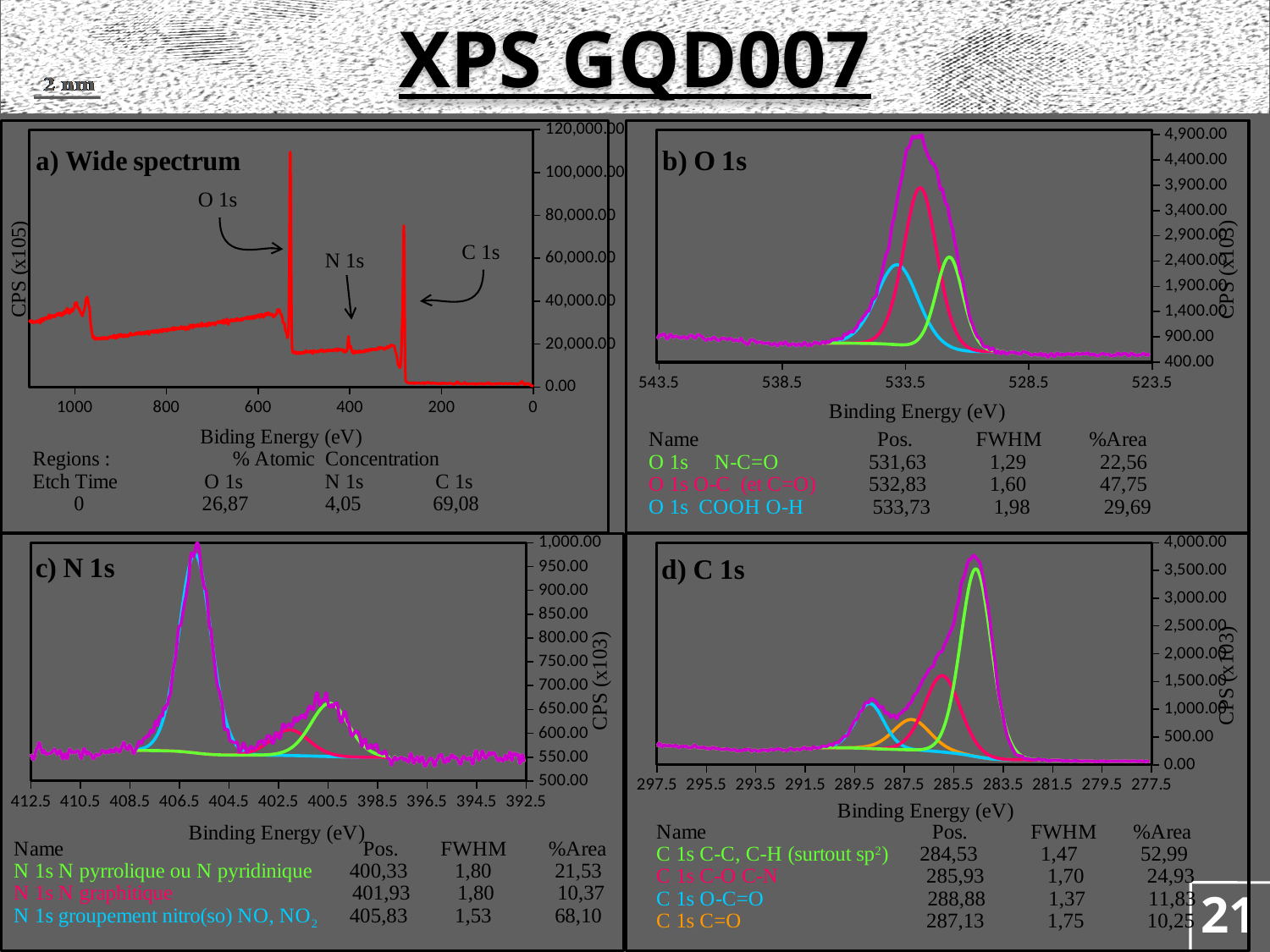
In the a) Wide spectrum panel, which region has the highest % Atomic Concentration? C 1s In the d) C 1s chart, what is the difference in %Area between C 1s C-C, C-H (surtout sp2) and C 1s C-O C-N? 28,06 In the b) O 1s chart, which component has the largest %Area? O 1s O-C (et C=O) In the b) O 1s chart, what is the %Area of the O 1s COOH O-H component? 29,69 In the d) C 1s chart, how many components are listed in the table? 4 What kind of chart is the a) Wide spectrum chart? line chart In the d) C 1s chart, what is the FWHM of the C 1s O-C=O component? 1,37 In the a) Wide spectrum panel, what is the % Atomic Concentration of C 1s? 69,08 In the b) O 1s chart, is the maximum of the magenta envelope curve greater or less than 4,400.00? greater In the c) N 1s chart, which has the larger %Area, N pyrrolique ou N pyridinique or N graphitique? N 1s N pyrrolique ou N pyridinique In the c) N 1s chart, is the peak of the magenta curve near 405.5 eV greater or less than 950.00? greater In the c) N 1s chart, what is the Pos. of the N 1s N graphitique component? 401,93